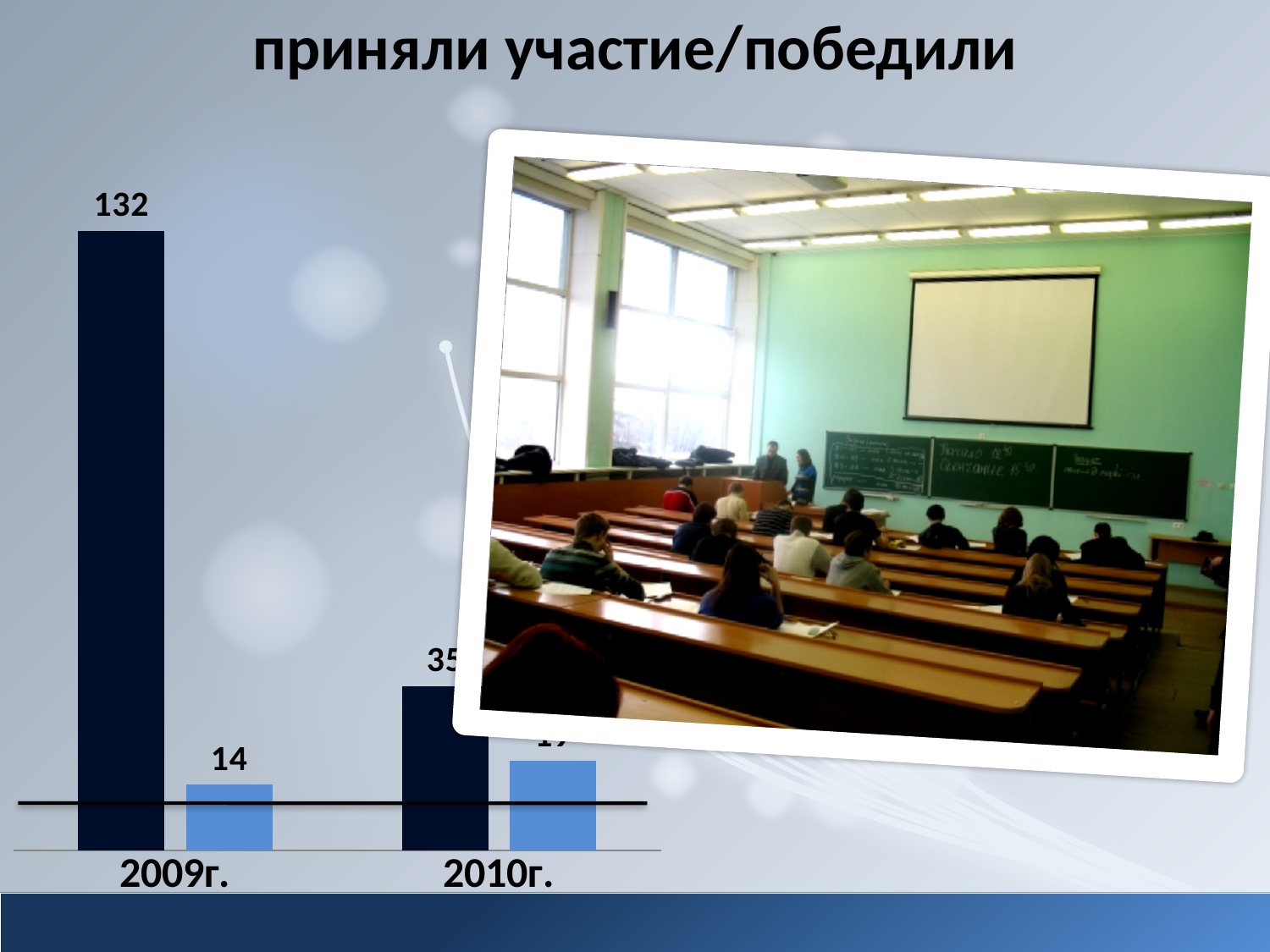
By how much does the dark blue bar for 2009г. exceed the dark blue bar for 2010г.? 97 What is the value of the dark blue bar for 2009г.? 132 Which is larger: the dark blue bar for 2009г. or the dark blue bar for 2010г.? 2009г. What is the difference between the dark blue and light blue bars for 2009г.? 118 Which bar on the chart is the shortest? The light blue bar for 2009г. Which bar on the chart is the tallest? The dark blue bar for 2009г. (132) Which is larger: the light blue bar for 2009г. or the dark blue bar for 2010г.? The dark blue bar for 2010г. What is the value of the light blue bar for 2009г.? 14 Do the dark blue bars rise or fall from 2009г. to 2010г.? Fall How many year categories are shown on the x axis? 2 What kind of chart is shown on the slide? Bar chart What is the value of the dark blue bar for 2010г.? 35